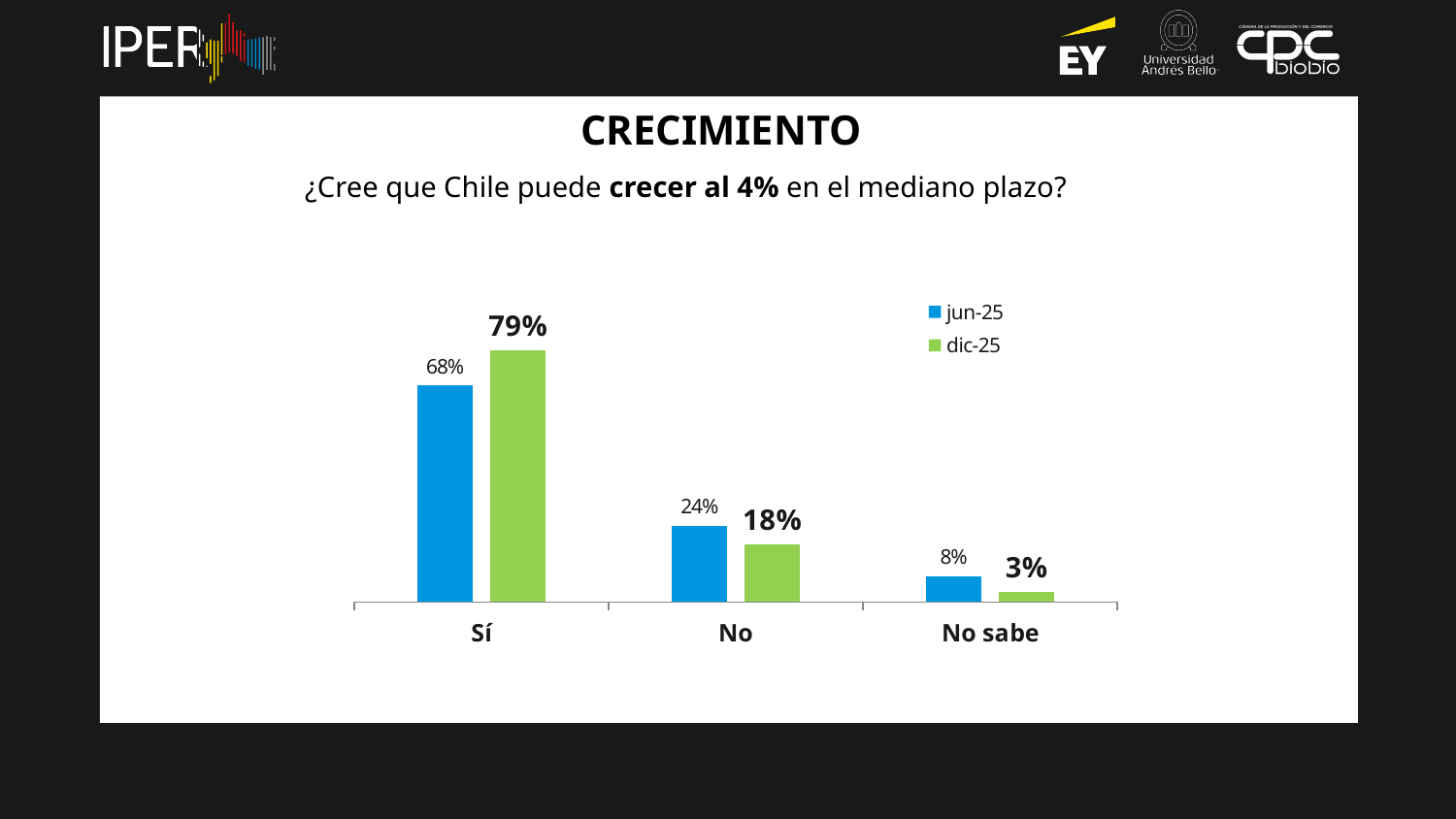
What is the value for "Sí" in the dic-25 series? 79% Which category has the highest value in the dic-25 series? Sí What is the value for "No sabe" in the dic-25 series? 3% How many series does the legend list? 2 Which category has the lowest value in the jun-25 series? No sabe How many categories are shown on the x axis? 3 What is the difference between the jun-25 and dic-25 values for "No"? 6 percentage points Which is larger for "No sabe": the jun-25 value or the dic-25 value? jun-25 What kind of chart is shown on the slide? Bar chart What is the value for "No" in the jun-25 series? 24% What is the value for "Sí" in the jun-25 series? 68% What is the difference between the dic-25 and jun-25 values for "Sí"? 11 percentage points